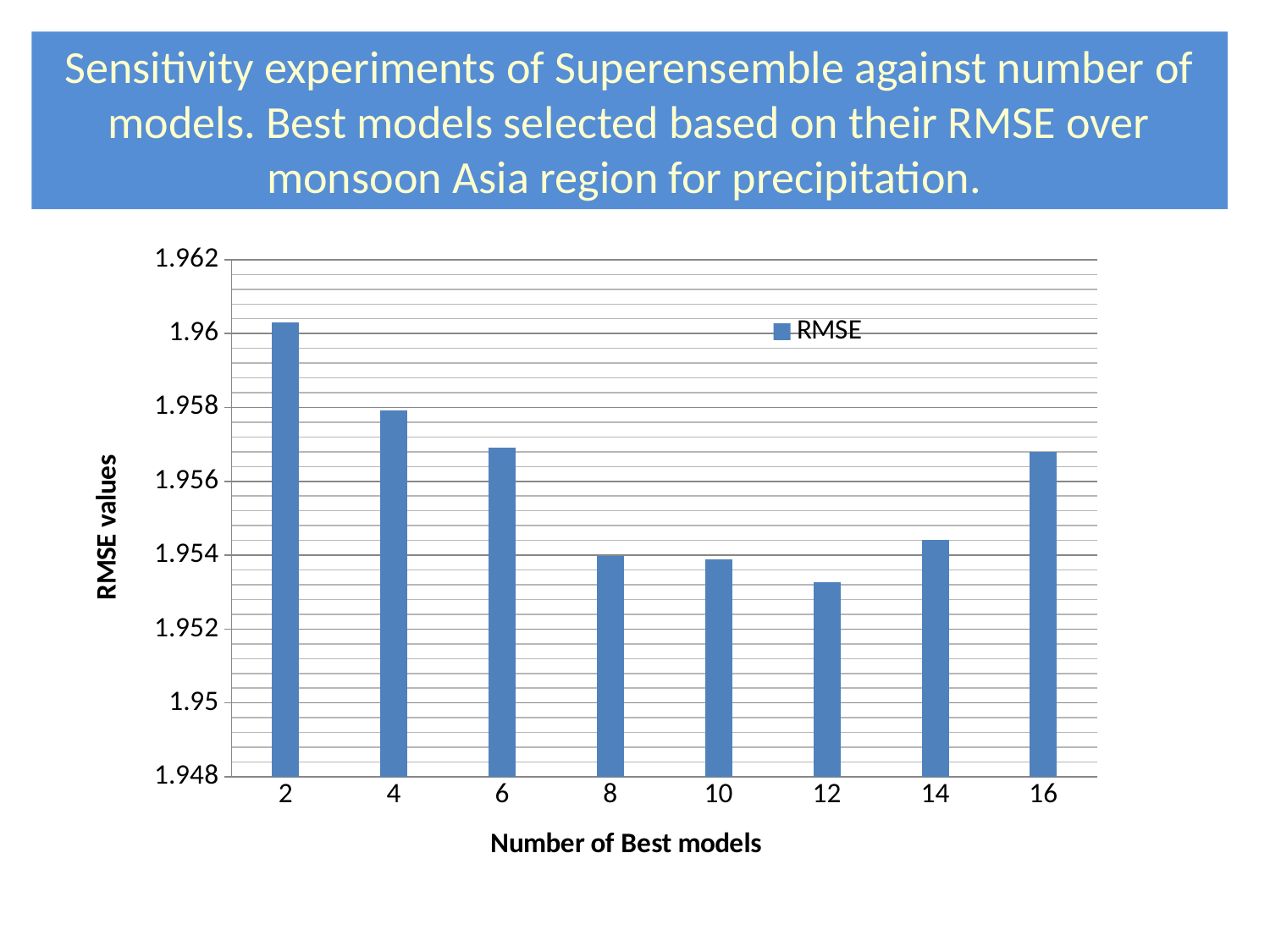
Which number of best models has the lowest RMSE value? 12 Is the RMSE value for 4 best models greater or less than 1.956? greater Which has the larger RMSE value: 12 best models or 14 best models? 14 How many series does the legend list? 1 Is the RMSE value for 16 best models greater or less than 1.956? greater Which number of best models has the highest RMSE value? 2 What kind of chart is shown on the slide? bar chart What is the title of the x axis? Number of Best models Is the RMSE value for 12 best models greater or less than 1.954? less Do the RMSE values rise or fall as the number of best models increases from 2 to 12? fall How many bars (categories) are plotted on the chart? 8 Which has the larger RMSE value: 2 best models or 16 best models? 2